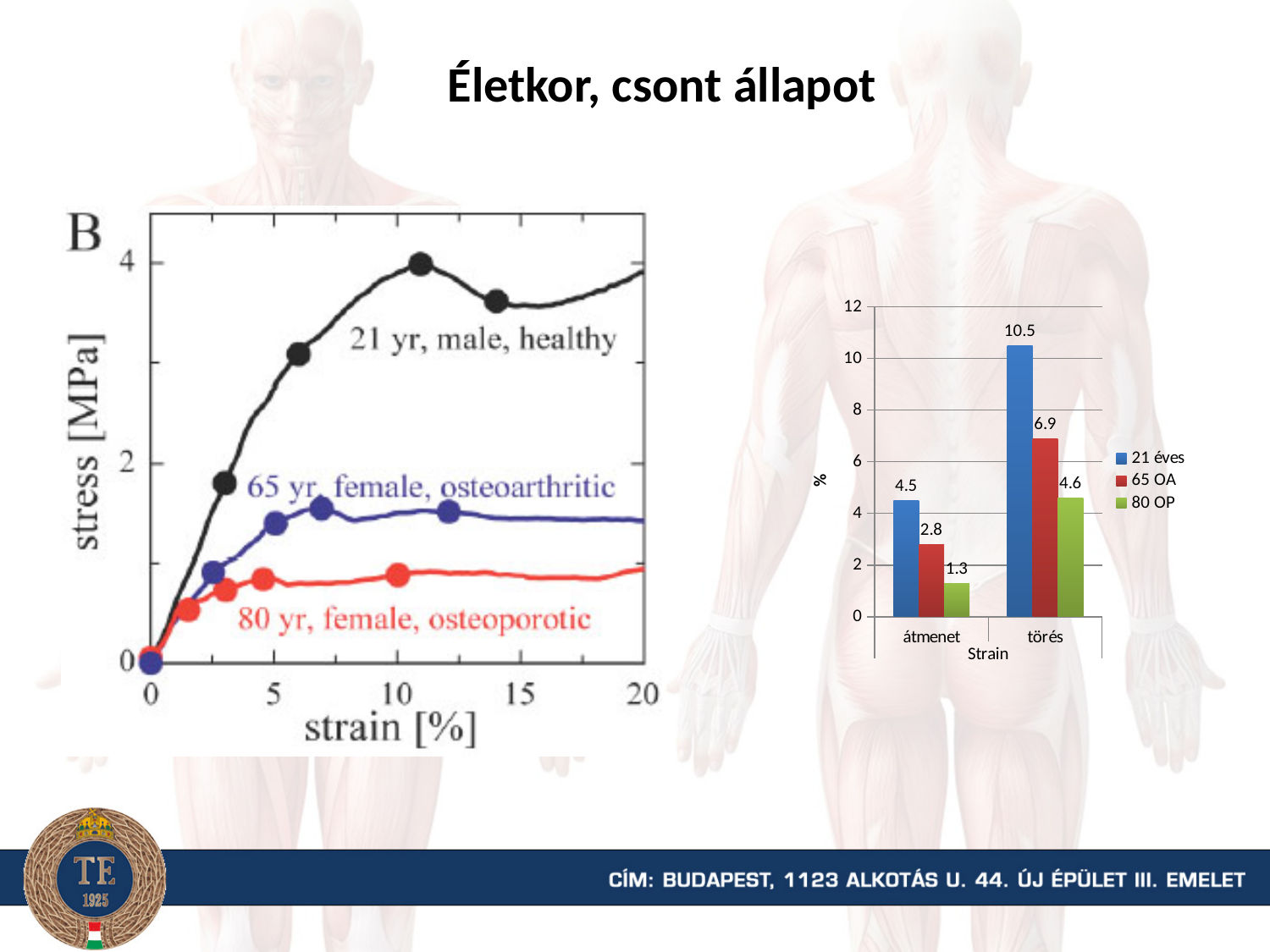
In the bar chart on the right, which series has the highest value in the törés category? 21 éves In the bar chart on the right, what is the value for 65 OA in the törés category? 6.9 How many series does the legend of the bar chart on the right list? 3 In the bar chart on the right, which series has the lowest value in the átmenet category? 80 OP In the bar chart on the right, which is larger: the 65 OA value for átmenet or the 80 OP value for törés? 80 OP value for törés In the bar chart on the right, what is the difference between the 21 éves and 65 OA values in the törés category? 3.6 In the line chart on the left, is the peak stress of the 80 yr, female, osteoporotic curve greater or less than 2 MPa? less In the line chart on the left, which curve reaches the highest stress? 21 yr, male, healthy How many categories are shown on the x axis of the bar chart on the right? 2 In the bar chart on the right, what is the value for 21 éves in the törés category? 10.5 What kind of chart is the chart on the left of the slide? line chart In the bar chart on the right, what is the value for 80 OP in the átmenet category? 1.3